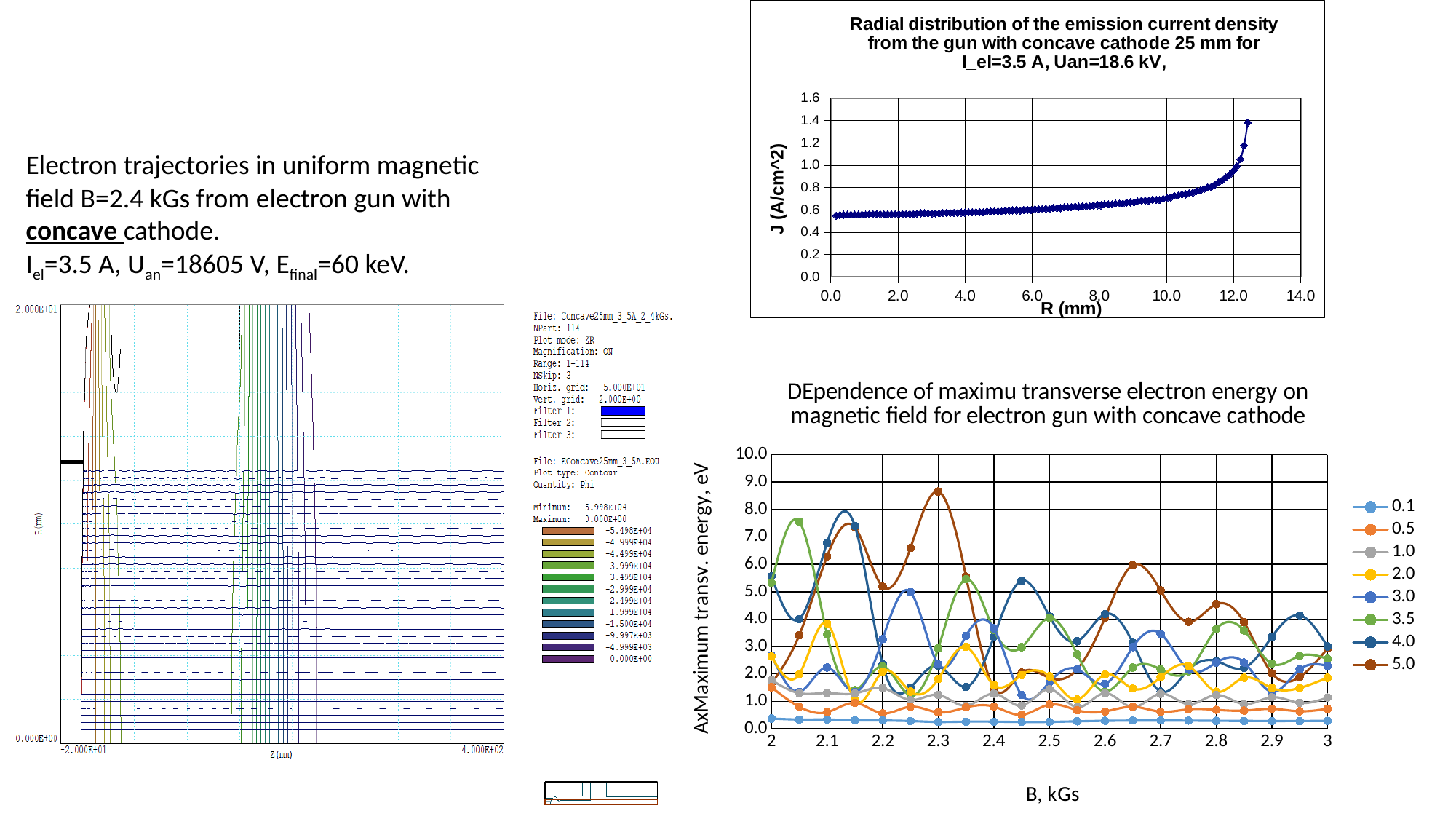
In the chart titled 'Radial distribution of the emission current density', what quantity is plotted on the y axis? J (A/cm^2) In the chart titled 'DEpendence of maximu transverse electron energy on magnetic field', is the value of the 0.1 series at B = 2 kGs greater or less than 1.0? less In the chart titled 'Radial distribution of the emission current density', is the highest plotted value of J greater or less than 1.2? greater In the chart titled 'Radial distribution of the emission current density', is the value of J at R = 10.0 mm greater or less than 1.0? less In the chart titled 'DEpendence of maximu transverse electron energy on magnetic field', which series has the lowest values across the whole B range? 0.1 How many series does the legend list in the chart titled 'DEpendence of maximu transverse electron energy on magnetic field'? 8 In the chart titled 'DEpendence of maximu transverse electron energy on magnetic field', what is the label of the x axis? B, kGs What kind of chart is the one titled 'DEpendence of maximu transverse electron energy on magnetic field'? line chart In the chart titled 'Radial distribution of the emission current density', do the values rise or fall as R increases? rise In the chart titled 'DEpendence of maximu transverse electron energy on magnetic field', which series reaches the highest value at B = 2.3 kGs? 5.0